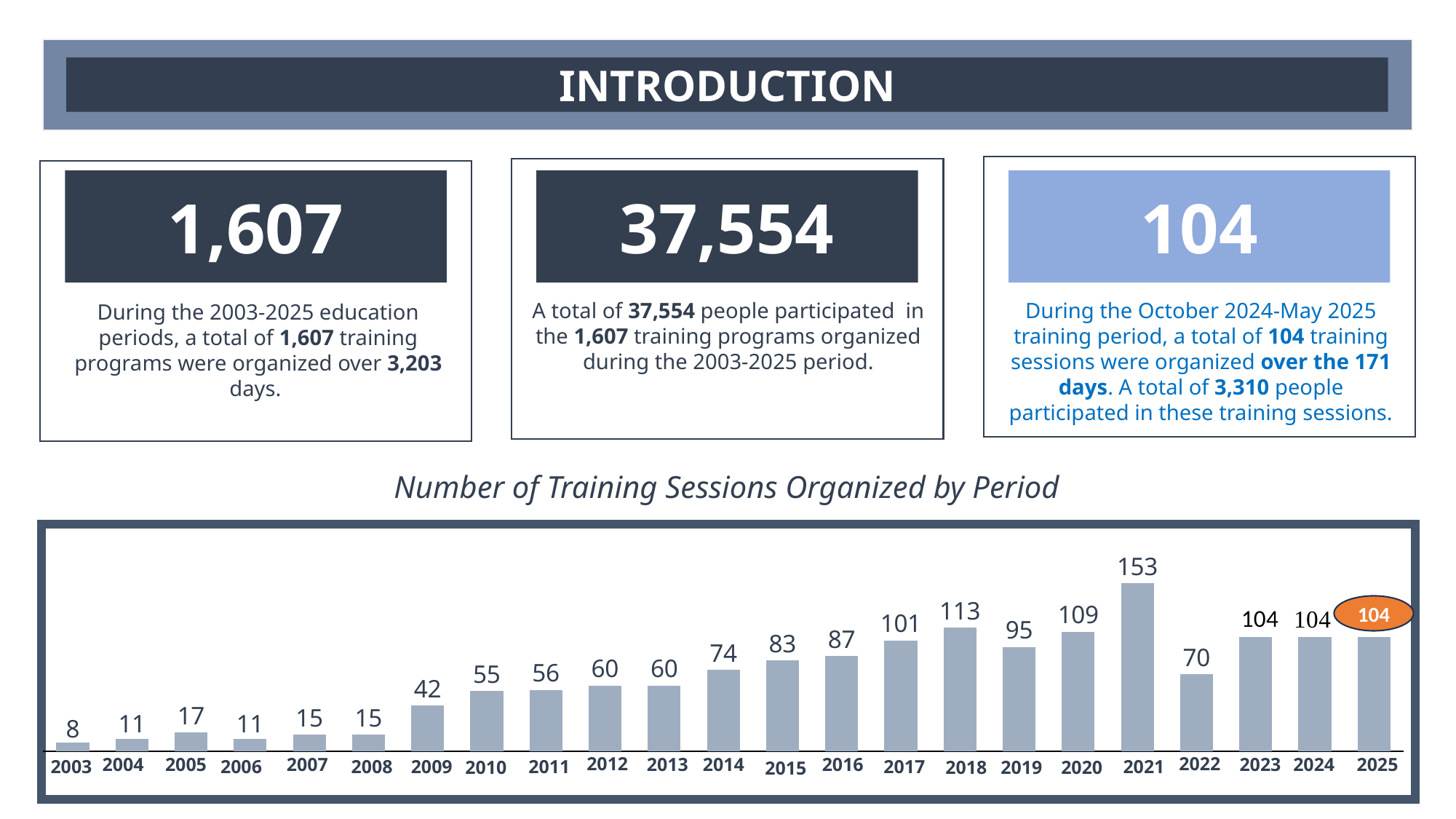
What kind of chart is shown on the slide? Bar chart Which year has the highest number of training sessions? 2021 What is the value for 2021 in the chart? 153 Do the values generally rise or fall from 2003 to 2021? Rise Which year has the lowest number of training sessions? 2003 What is the value for 2009 in the chart? 42 What is the value for 2022 in the chart? 70 How many years are shown on the x axis of the chart? 23 Which year's data label is highlighted with an orange oval? 2025 What is the difference between the values for 2021 and 2022? 83 Which is larger, the value for 2018 or the value for 2019? 2018 What is the title of the chart? Number of Training Sessions Organized by Period